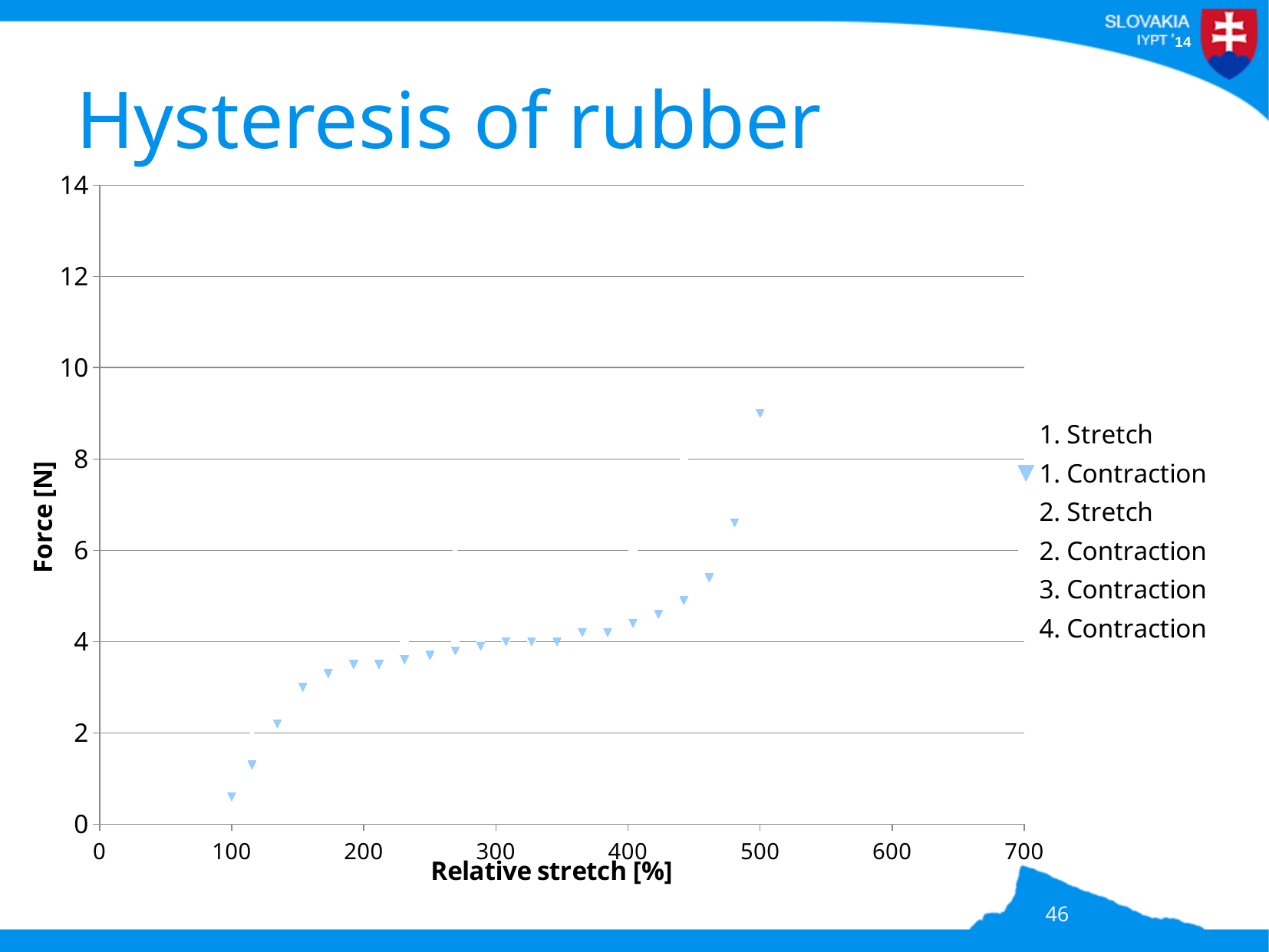
Which is larger, the force at 500% relative stretch or the force at 300% relative stretch? 500% At which relative stretch value is the plotted force highest? 500% How many series does the legend list? 6 Does the force rise or fall as relative stretch increases along the x axis? rise Is the force at a relative stretch of 100% greater or less than 2 N? less What is the title of the chart? Hysteresis of rubber Is the force at a relative stretch of 500% greater or less than 8 N? greater Is the force at a relative stretch of about 480% greater or less than 6 N? greater At which relative stretch value is the plotted force lowest? 100% What kind of chart is shown on the slide? scatter chart What is the label of the vertical axis? Force [N]